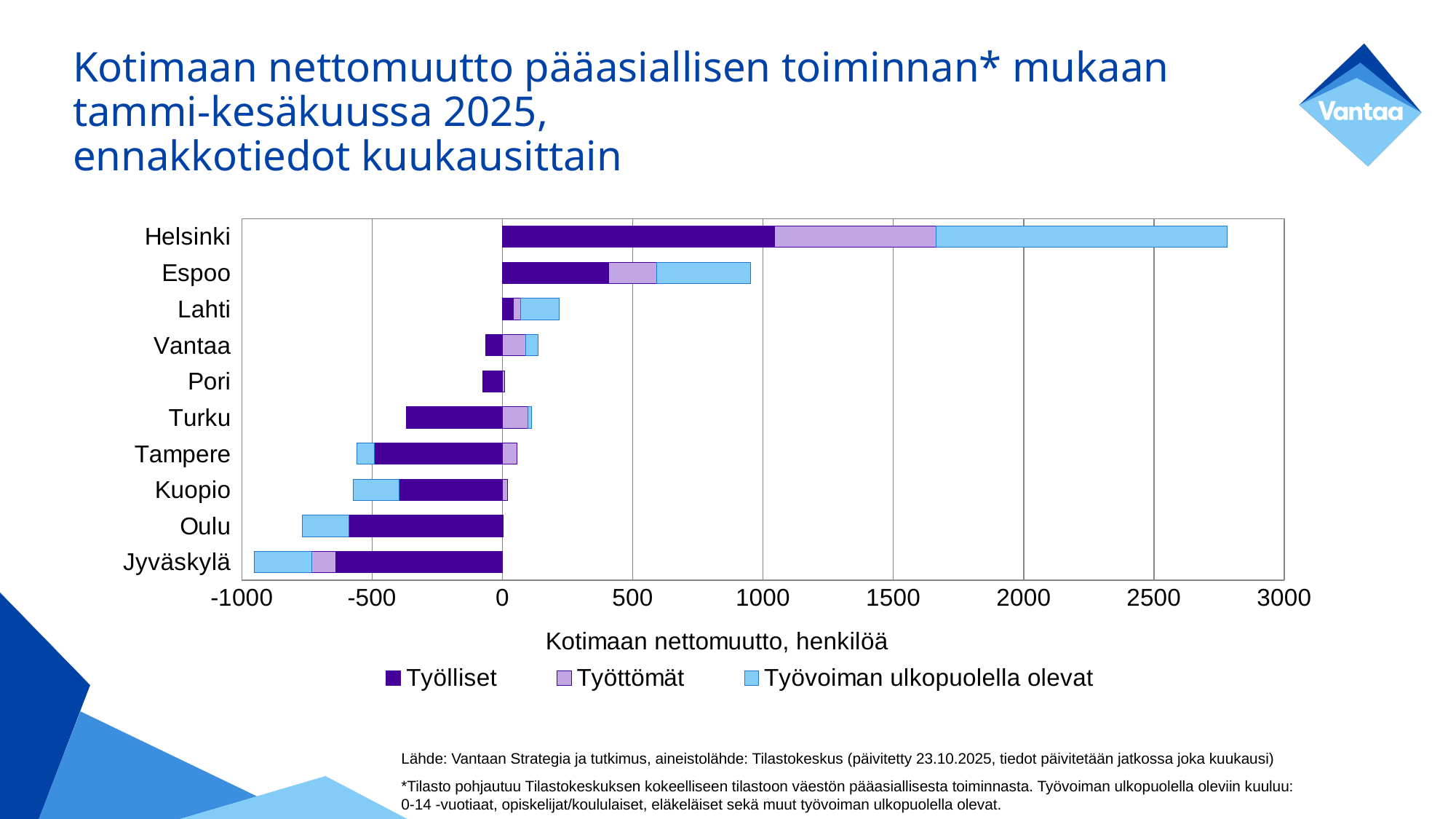
How many cities are listed on the vertical axis of the chart? 10 Which series in the legend is shown in light blue? Työvoiman ulkopuolella olevat Which city has the highest total net domestic migration in the chart? Helsinki What kind of chart is shown on the slide? Stacked bar chart What is the title of the horizontal axis of the chart? Kotimaan nettomuutto, henkilöä How many series does the chart legend list? 3 Is the total net domestic migration for Espoo greater or less than 1000? less Which city has the larger Työlliset value, Helsinki or Espoo? Helsinki Is the Työlliset value for Jyväskylä greater or less than -500? less Is the Työlliset value for Turku greater or less than -500? greater Which city has the lowest (most negative) total net domestic migration in the chart? Jyväskylä